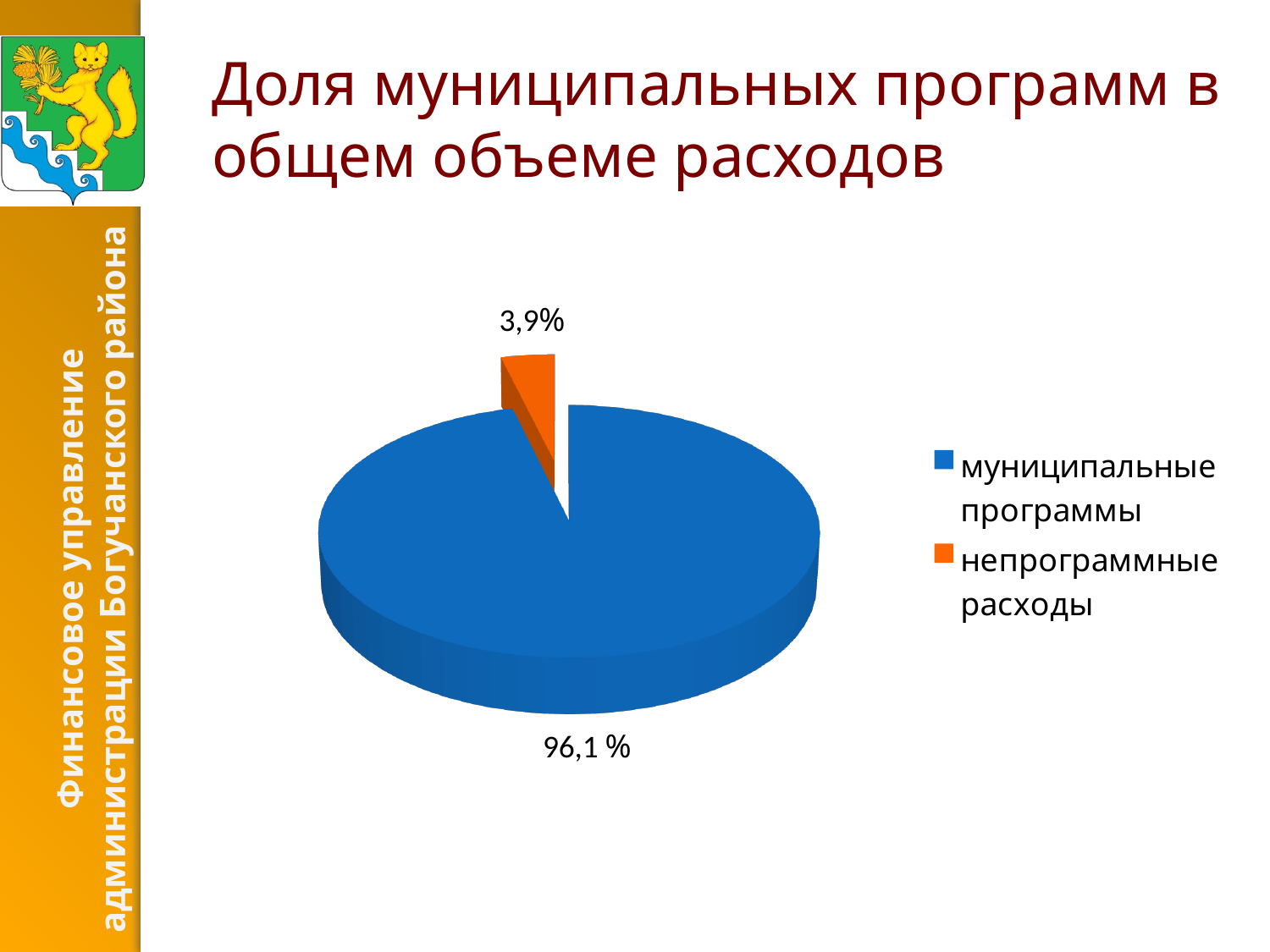
How many slices does the pie chart have? 2 What kind of chart is shown on the slide? pie chart Which category has the smallest slice of the pie? непрограммные расходы What is the title of the slide containing the chart? Доля муниципальных программ в общем объеме расходов What colour is the slice for непрограммные расходы? orange What share of the pie is labelled for непрограммные расходы? 3,9% What share of the pie is labelled for муниципальные программы? 96,1 % Which category has the largest slice of the pie? муниципальные программы How many entries does the legend list? 2 What is the difference in percentage points between the муниципальные программы slice and the непрограммные расходы slice? 92,2 Which is larger: the slice for муниципальные программы or the slice for непрограммные расходы? муниципальные программы